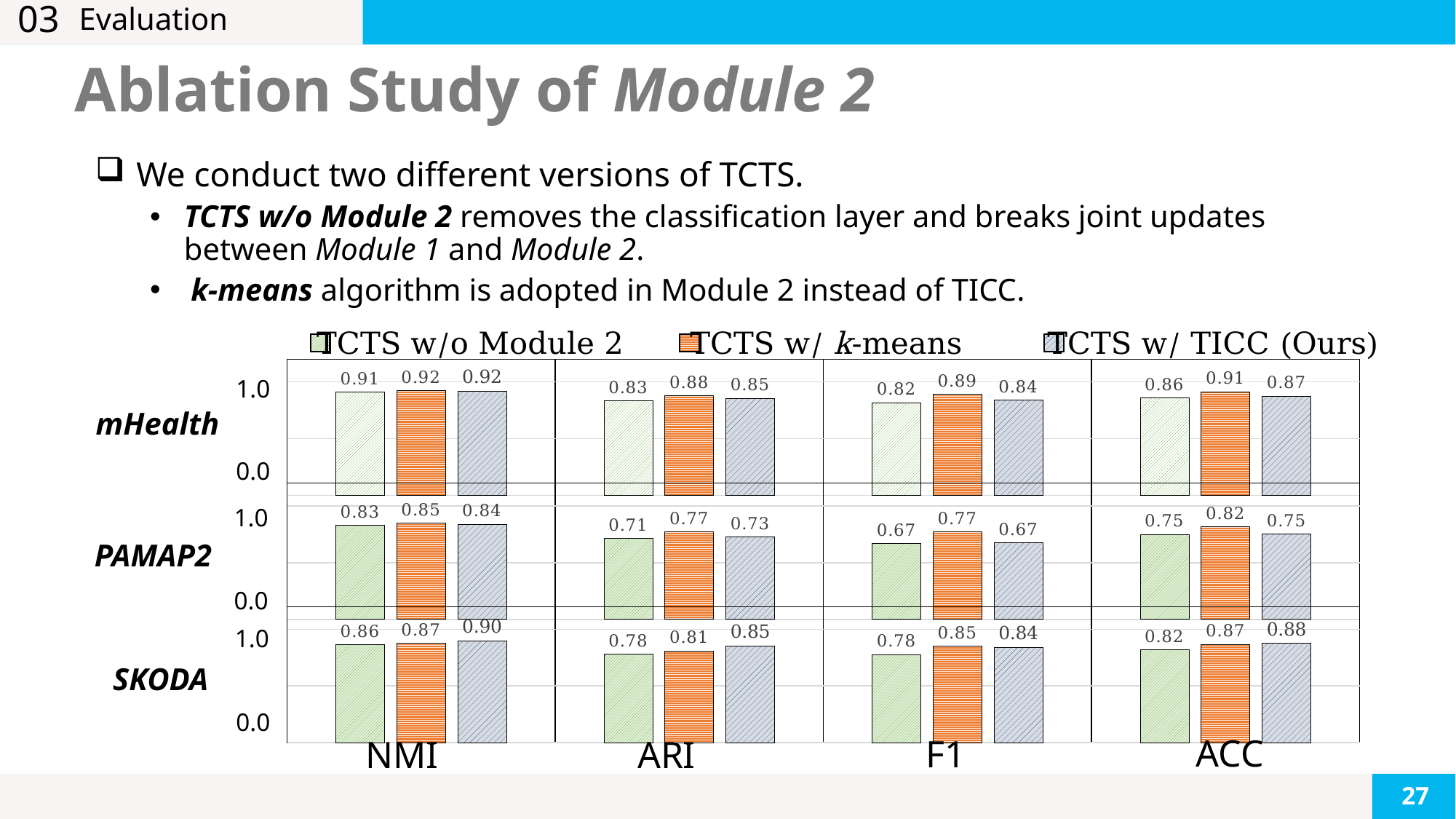
In the PAMAP2 row, what is the F1 value for TCTS w/o Module 2? 0.67 In the mHealth row, what is the ARI value for TCTS w/ k-means? 0.88 In the SKODA row, which method has the lowest ARI value? TCTS w/o Module 2 What kind of chart is used on this slide? Bar chart In the PAMAP2 row, which method has the highest ACC value? TCTS w/ k-means In the PAMAP2 row, what is the difference between the ARI values of TCTS w/ k-means and TCTS w/ TICC (Ours)? 0.04 In the SKODA row, which is larger: the ACC value for TCTS w/ TICC (Ours) or for TCTS w/o Module 2? TCTS w/ TICC (Ours) In the SKODA row, what is the NMI value for TCTS w/ TICC (Ours)? 0.90 How many metric groups are shown along the x axis of each row? 4 Which dataset rows are shown in the chart, from top to bottom? mHealth, PAMAP2, SKODA In the mHealth row, what is the difference between the F1 values of TCTS w/ k-means and TCTS w/o Module 2? 0.07 How many series does the legend list? 3